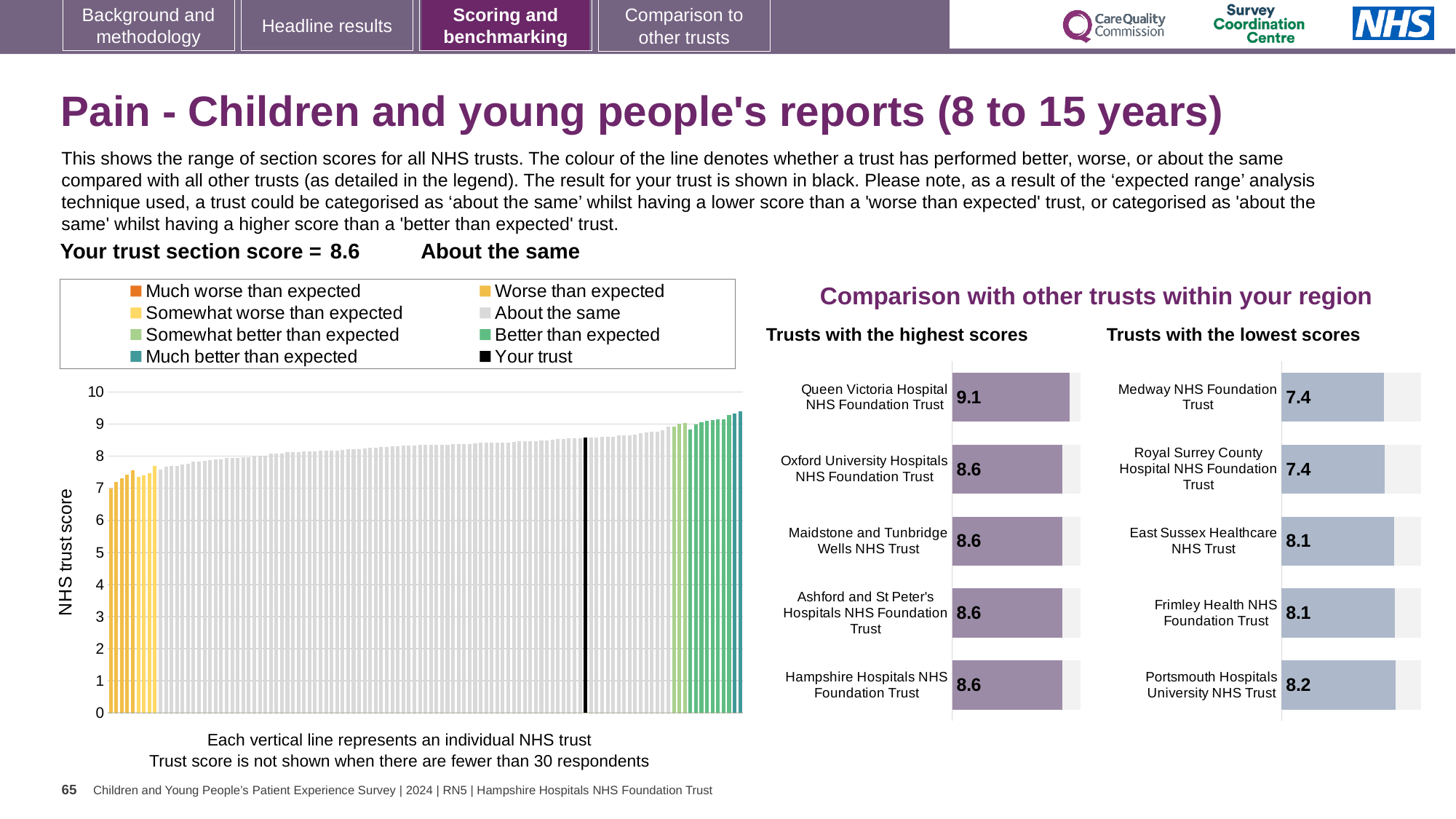
In the large chart on the left, do the bar values rise or fall from left to right? rise In the 'Trusts with the highest scores' chart, what is the score for Queen Victoria Hospital NHS Foundation Trust? 9.1 In the 'Trusts with the highest scores' chart, what is the difference between the score for Queen Victoria Hospital NHS Foundation Trust and the score for Hampshire Hospitals NHS Foundation Trust? 0.5 How many trusts are listed in the 'Trusts with the lowest scores' chart? 5 In the 'Trusts with the lowest scores' chart, what is the score for Portsmouth Hospitals University NHS Trust? 8.2 How many entries does the legend of the large chart on the left list? 8 Which is larger: the score for Queen Victoria Hospital NHS Foundation Trust in the 'Trusts with the highest scores' chart or the score for Medway NHS Foundation Trust in the 'Trusts with the lowest scores' chart? Queen Victoria Hospital NHS Foundation Trust In the 'Trusts with the lowest scores' chart, which trust has the highest score shown? Portsmouth Hospitals University NHS Trust In the 'Trusts with the highest scores' chart, which trust has the highest score? Queen Victoria Hospital NHS Foundation Trust In the large chart on the left, is the value of the leftmost bar greater or less than 8? less In the 'Trusts with the lowest scores' chart, what is the difference between the score for Portsmouth Hospitals University NHS Trust and the score for Medway NHS Foundation Trust? 0.8 In the 'Trusts with the lowest scores' chart, what is the score for Medway NHS Foundation Trust? 7.4